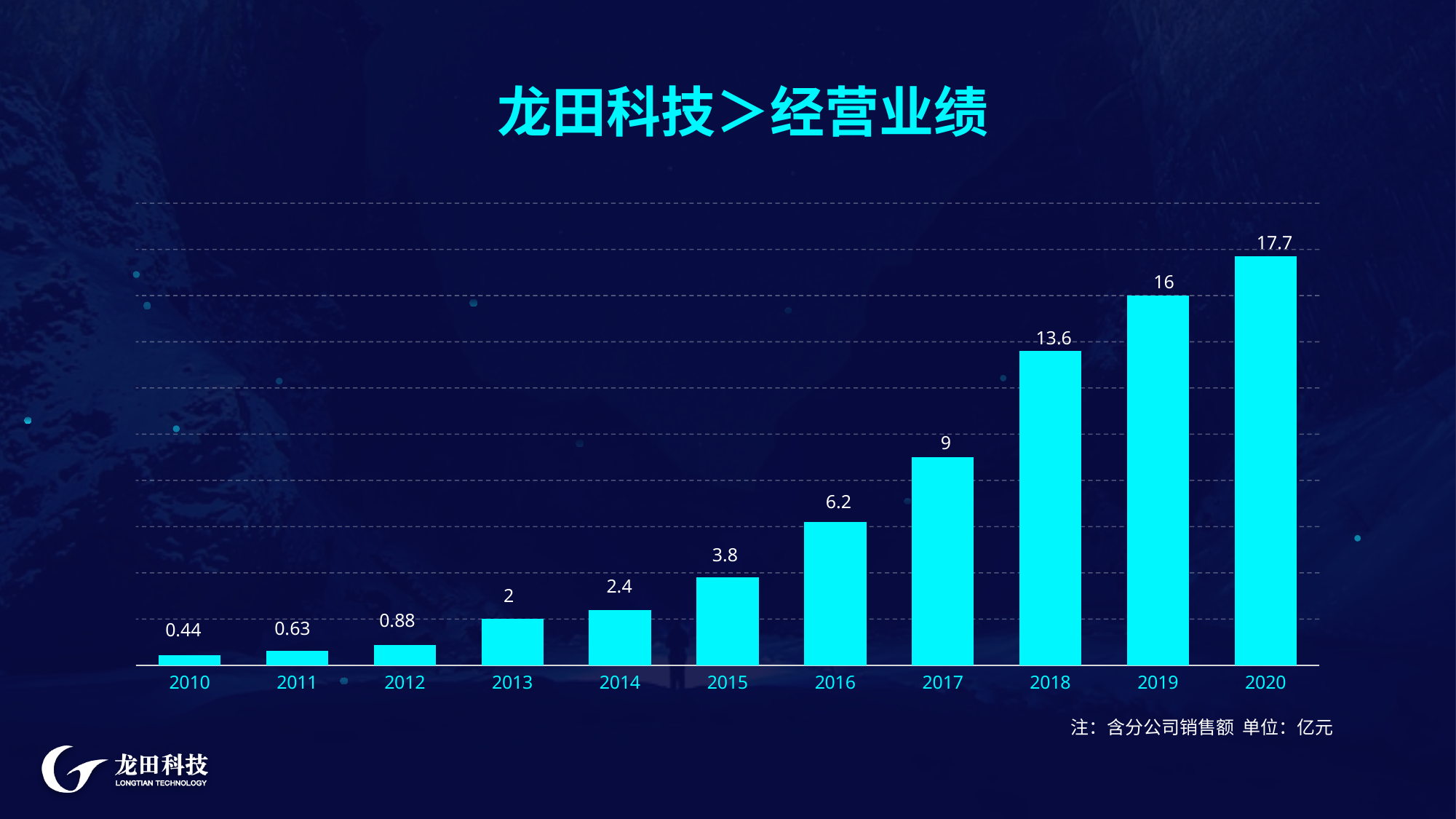
What is the value for 2010? 0.44 Which year has the highest value? 2020 Which is larger, the value for 2015 or the value for 2014? 2015 What is the difference between the values for 2017 and 2016? 2.8 What unit is stated in the note below the chart? 亿元 What is the value for 2018? 13.6 What kind of chart is shown on the slide? Bar chart Which year has the lowest value? 2010 Do the values rise or fall from 2010 to 2020? Rise What is the difference between the values for 2020 and 2019? 1.7 How many years are shown on the x axis? 11 What is the value for 2016? 6.2